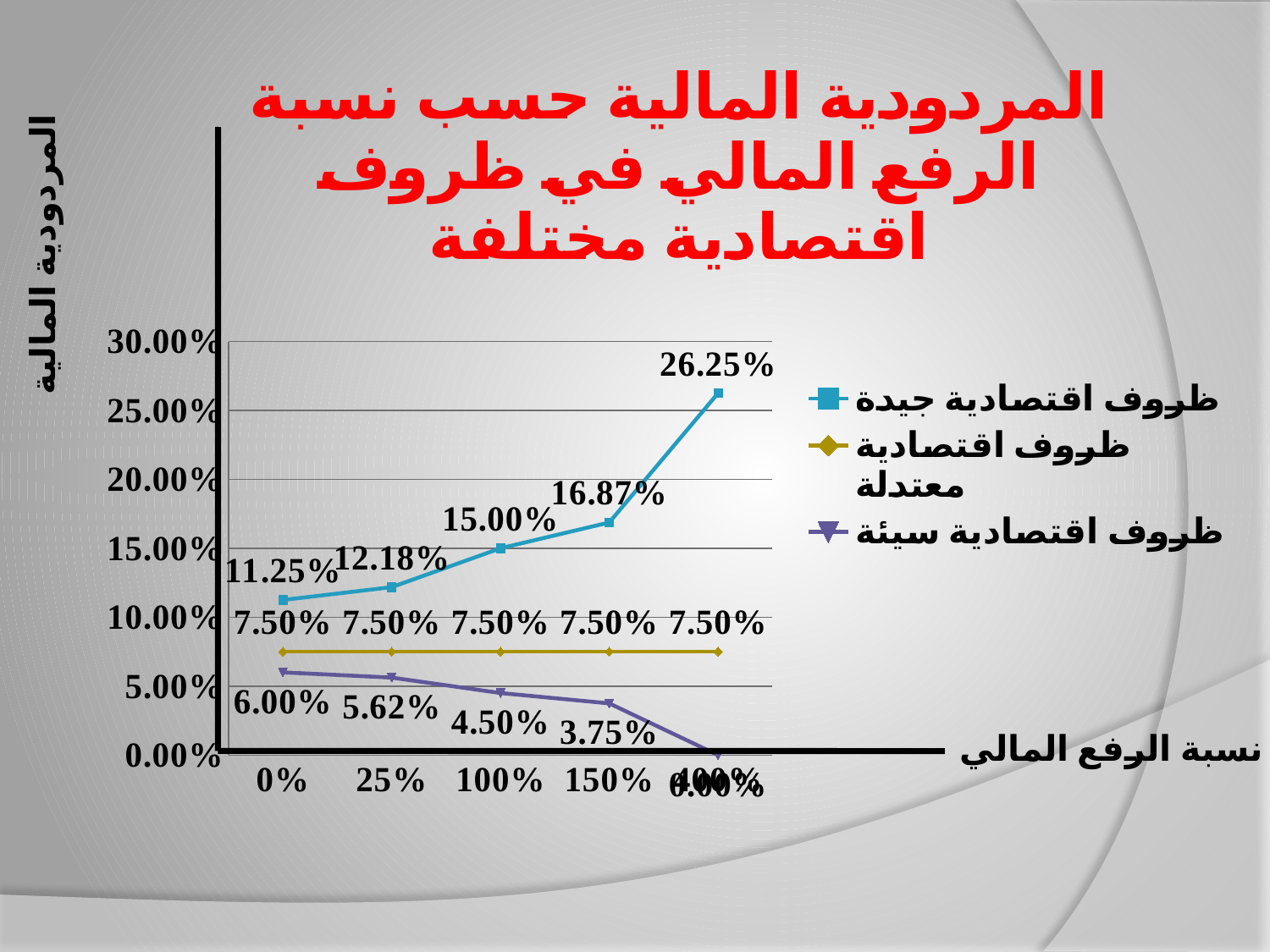
By how much does the 'ظروف اقتصادية جيدة' value at 25% exceed its value at 0%? 0.93% What is the value of the 'ظروف اقتصادية معتدلة' series at 150%? 7.50% How many points are plotted along the x axis for each series? 5 What is the value of the 'ظروف اقتصادية سيئة' series at 25%? 5.62% What is the title of the chart? المردودية المالية حسب نسبة الرفع المالي في ظروف اقتصادية مختلفة At 0%, which series has the larger value: 'ظروف اقتصادية جيدة' or 'ظروف اقتصادية سيئة'? ظروف اقتصادية جيدة What is the highest value plotted for the 'ظروف اقتصادية جيدة' series? 26.25% What is the difference between the 'ظروف اقتصادية جيدة' value and the 'ظروف اقتصادية سيئة' value at 150%? 13.12% What type of chart is shown on the slide? line chart What is the value of the 'ظروف اقتصادية جيدة' series at 100%? 15.00% Do the values of the 'ظروف اقتصادية سيئة' series rise or fall along the x axis? fall How many series does the legend list? 3